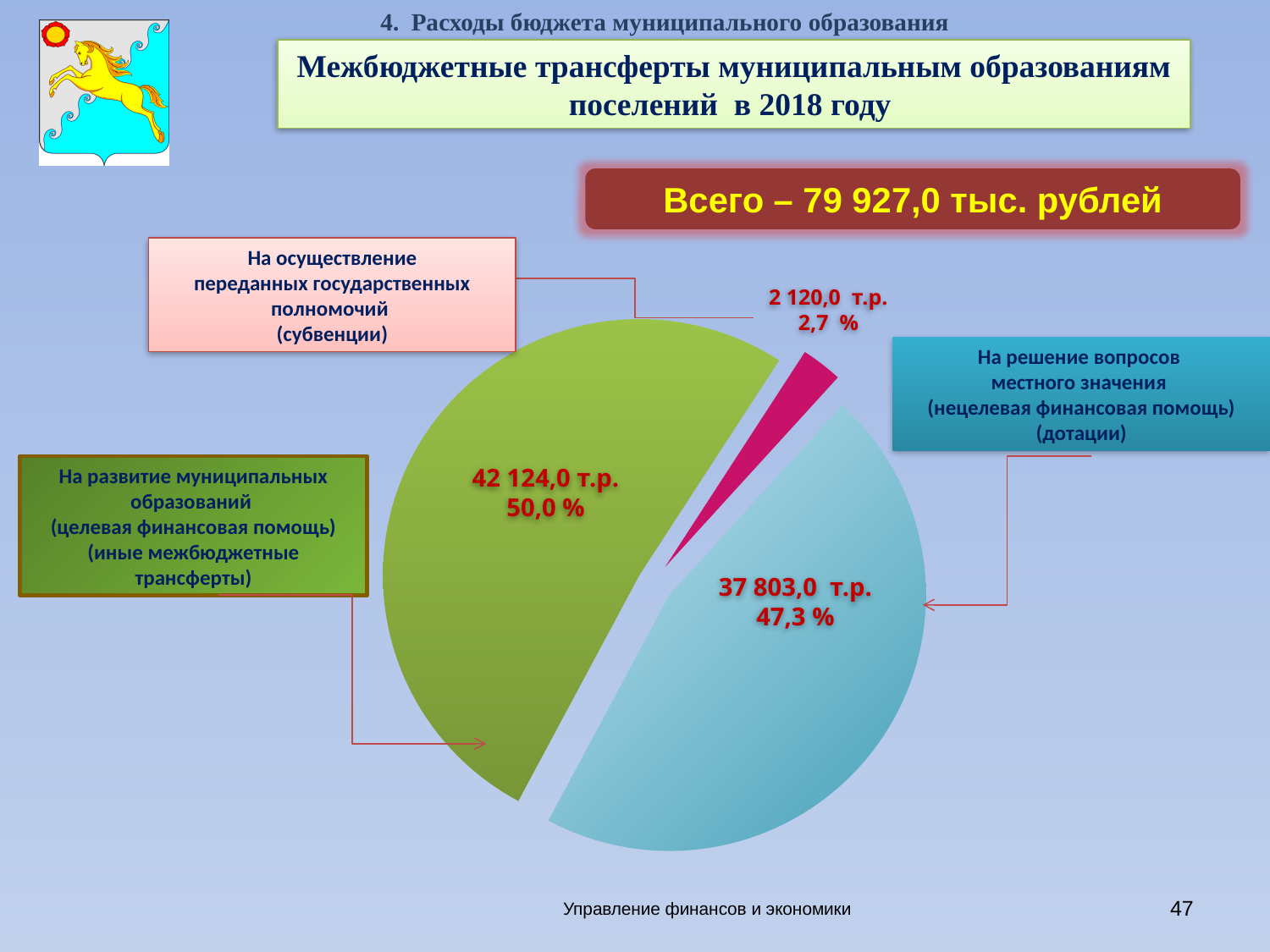
What is the value of the slice for 'На развитие муниципальных образований (иные межбюджетные трансферты)'? 42 124,0 т.р. How many slices does the pie chart have? 3 What total amount is stated on the slide for the pie chart? 79 927,0 тыс. рублей Which is larger: the 'дотации' slice or the 'субвенции' slice? дотации Which slice of the pie chart is the smallest? На осуществление переданных государственных полномочий (субвенции) What is the value of the slice for 'На решение вопросов местного значения (дотации)'? 37 803,0 т.р. What kind of chart is shown on the slide? pie chart What is the value of the slice for 'На осуществление переданных государственных полномочий (субвенции)'? 2 120,0 т.р. Which slice of the pie chart is the largest? На развитие муниципальных образований (иные межбюджетные трансферты) What share of the pie does the 'субвенции' slice represent? 2,7 % What share of the pie does the 'дотации' slice represent? 47,3 % What is the difference between the 'иные межбюджетные трансферты' slice and the 'дотации' slice in т.р.? 4 321,0 т.р.